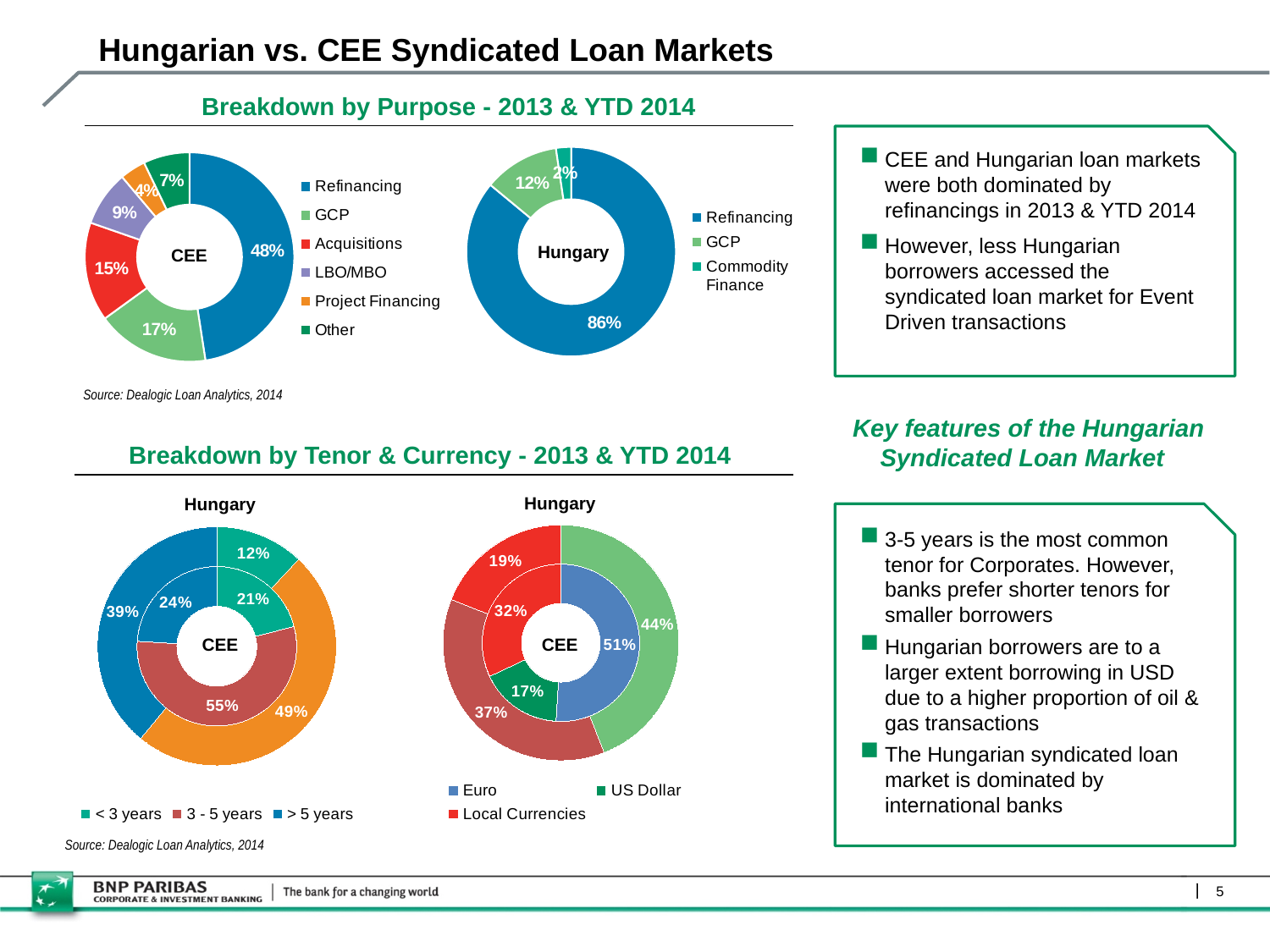
In the Breakdown by Purpose chart for CEE, which is larger, GCP or Acquisitions? GCP In the Breakdown by Purpose chart for CEE, which purpose has the smallest share? Project Financing In the Breakdown by Purpose chart for CEE, how many entries does the legend list? 6 How many percentage points higher is the Refinancing share for Hungary than for CEE in the Breakdown by Purpose charts? 38 percentage points In the Breakdown by Currency chart, what share of CEE loans are in Euro? 51% In the Breakdown by Purpose chart for Hungary, how many purpose categories are shown? 3 In the Breakdown by Purpose chart for CEE, what share is Refinancing? 48% In the Breakdown by Tenor chart, what share of Hungary's loans have a 3 - 5 years tenor? 49% In the Breakdown by Tenor chart, what share of CEE loans have a 3 - 5 years tenor? 55% What type of chart is used for the Breakdown by Purpose for CEE? Donut (pie) chart In the Breakdown by Purpose chart for Hungary, what share is Commodity Finance? 2% In the Breakdown by Purpose chart for Hungary, what share is Refinancing? 86%